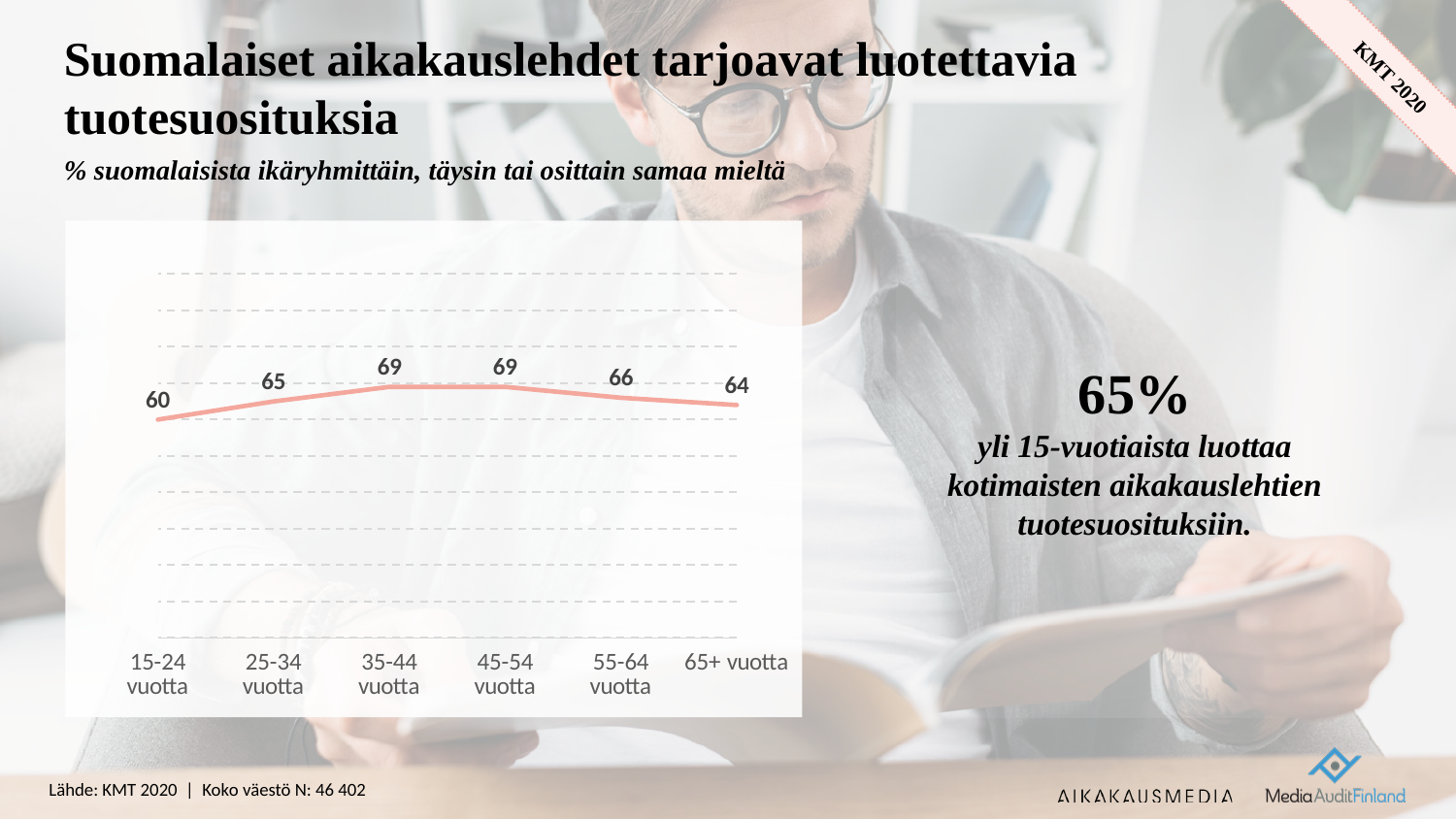
Which is larger, the value for 25-34 vuotta or the value for 65+ vuotta? 25-34 vuotta What is the value for the 65+ vuotta age group? 64 What is the difference between the values for 35-44 vuotta and 15-24 vuotta? 9 What is the highest value shown on the chart? 69 Which age group has the lowest value? 15-24 vuotta What is the value for the 55-64 vuotta age group? 66 What is the value for the 15-24 vuotta age group? 60 What is the difference between the values for 55-64 vuotta and 65+ vuotta? 2 What kind of chart is shown on the slide? Line chart How many age groups are plotted on the chart? 6 What is the value for the 25-34 vuotta age group? 65 Do the values rise or fall from 45-54 vuotta to 65+ vuotta? Fall